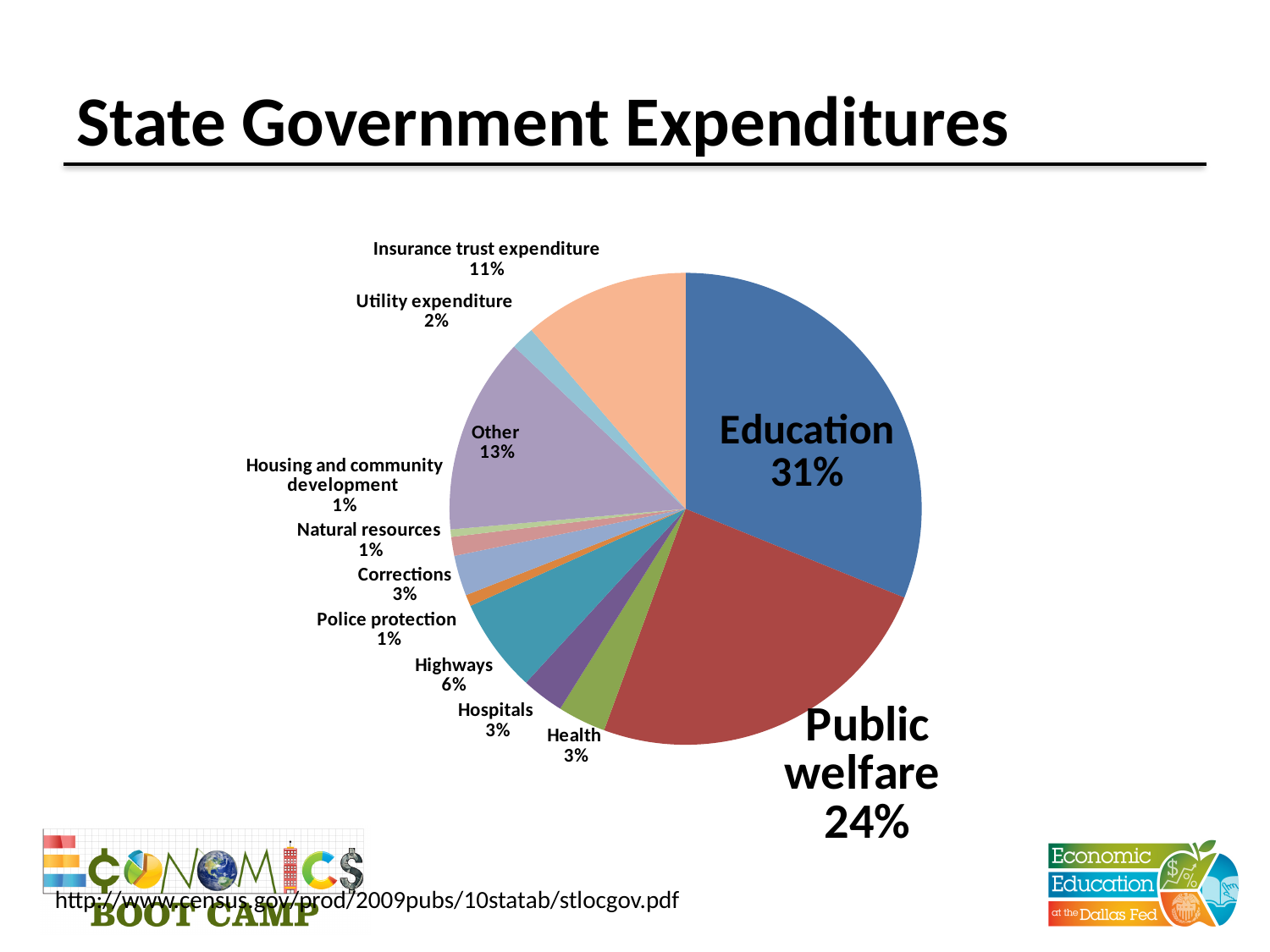
What is the share for Insurance trust expenditure? 11% What share is labelled for Other? 13% How many percentage points larger is Education than Public welfare? 7 How many categories are shown in the pie chart? 12 Which category has the largest share of the pie? Education What percentage is shown for Highways? 6% What is the title of the slide containing the pie chart? State Government Expenditures What share of state government expenditures goes to Education? 31% What is the difference in percentage points between Highways and Corrections? 3 Which is larger, the share for Other or the share for Insurance trust expenditure? Other What type of chart is shown on the slide? pie chart What percentage of expenditures is Public welfare? 24%